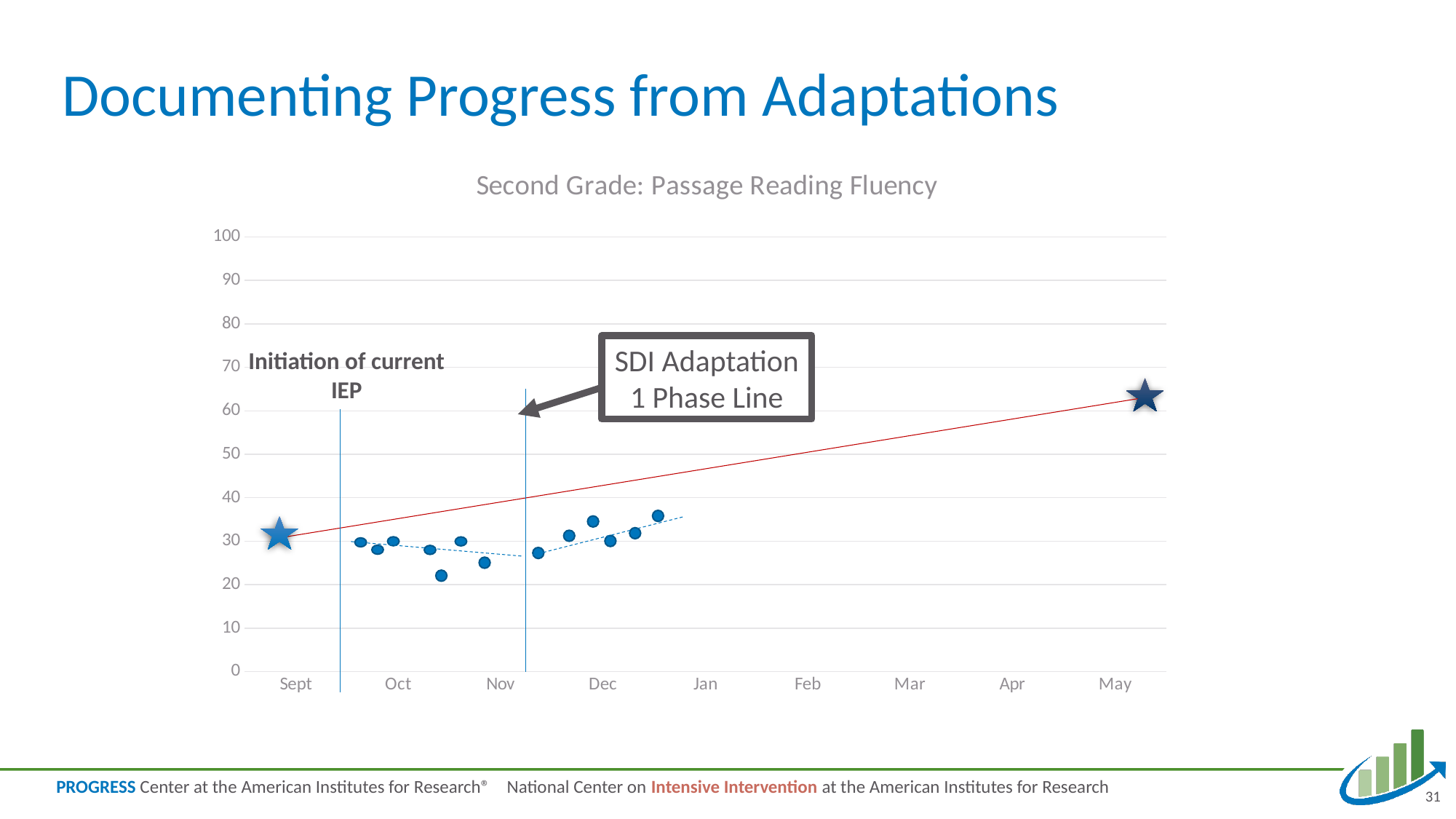
Is the highest blue data point in the chart greater or less than 40? less How many month labels are shown on the x axis of the chart? 9 Does the red goal line rise or fall from Sept to May? rise What label is attached to the vertical phase line in the chart? SDI Adaptation 1 Phase Line What is the highest value shown on the y axis of the chart? 100 Which star marker has the larger value, the one at Sept or the one at May? May Is the value of the star marker at May greater or less than 60? greater What is the title of the chart? Second Grade: Passage Reading Fluency Is the lowest plotted data point in the chart greater or less than 30? less Do the blue data points after the SDI Adaptation phase line generally rise or fall over time? rise